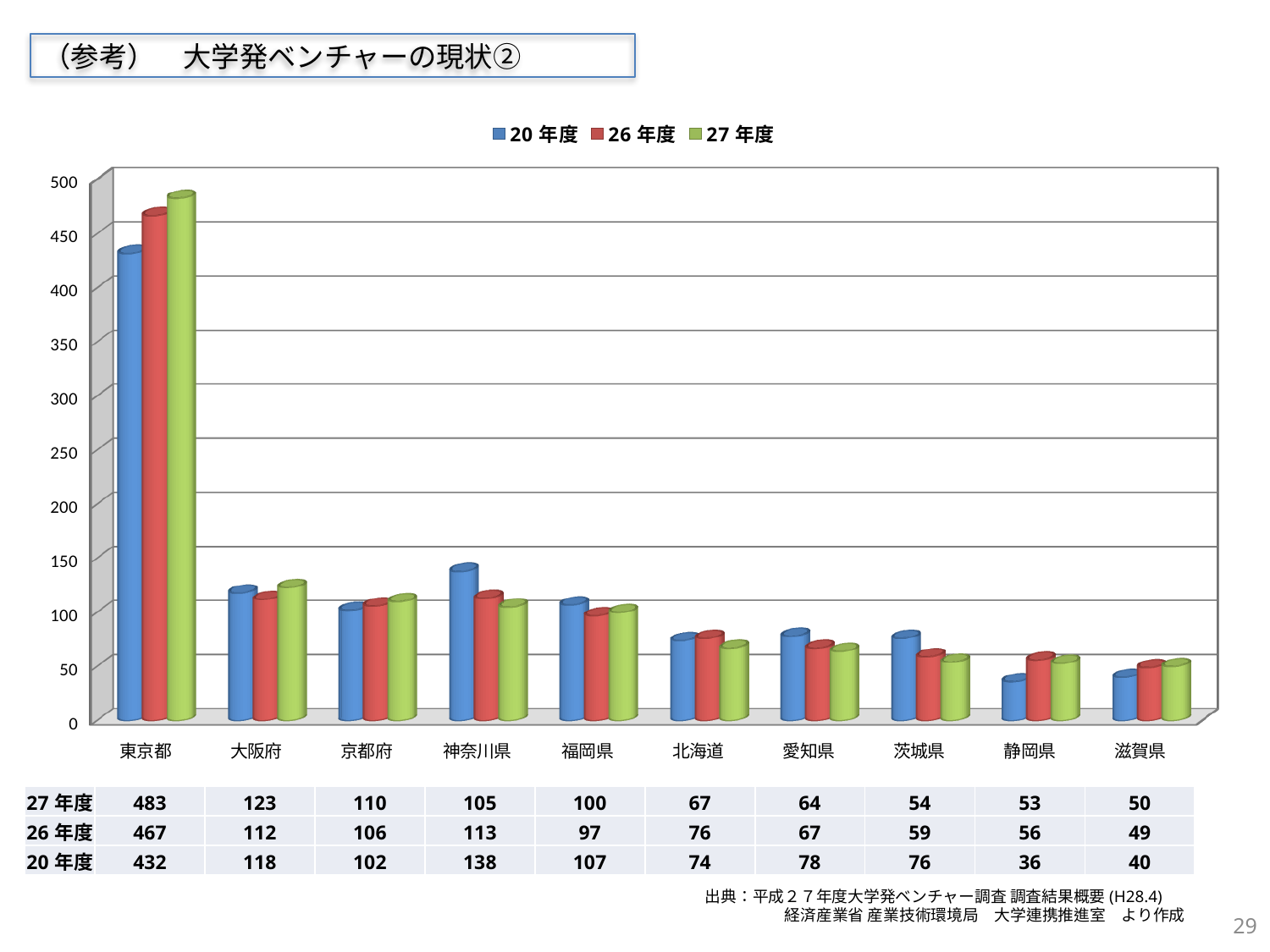
Which prefecture has the lowest 20 年度 value? 静岡県 What is the 26 年度 value for 北海道? 76 Which colour represents the 27 年度 series in the legend? green What is the 27 年度 value for 東京都? 483 What kind of chart is shown on the slide? bar chart How many prefectures are shown on the x axis? 10 Is the 26 年度 value for 大阪府 greater or less than 100? greater What is the 20 年度 value for 神奈川県? 138 Which prefecture has the highest 27 年度 value? 東京都 What is the difference between the 27 年度 and 20 年度 values for 東京都? 51 How many series does the legend list? 3 Which is larger for 神奈川県: the 20 年度 value or the 27 年度 value? 20 年度